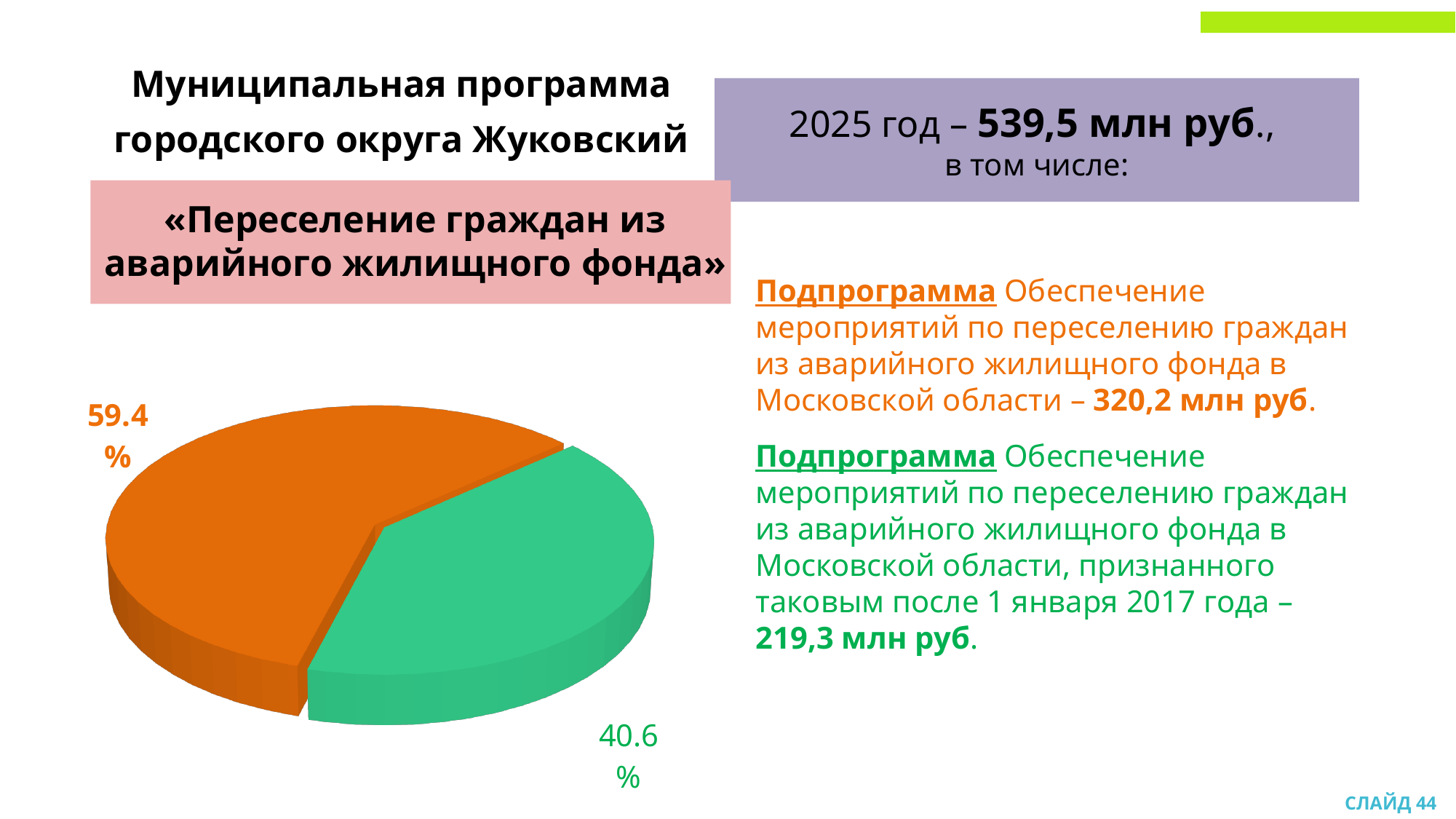
Is the share of the green slice greater or less than 50%? less What share of the pie does the green slice represent? 40.6% What kind of chart is shown on the slide? pie chart What colour is the slice labelled 40.6%? green By how many percentage points does the orange slice exceed the green slice? 18.8% Is the share of the orange slice greater or less than 50%? greater Which is larger, the orange slice or the green slice? the orange slice What colour is the slice labelled 59.4%? orange Which slice of the pie chart is the smallest? the green slice (40.6%) What share of the pie does the orange slice represent? 59.4% How many slices does the pie chart have? 2 Which slice of the pie chart is the largest? the orange slice (59.4%)